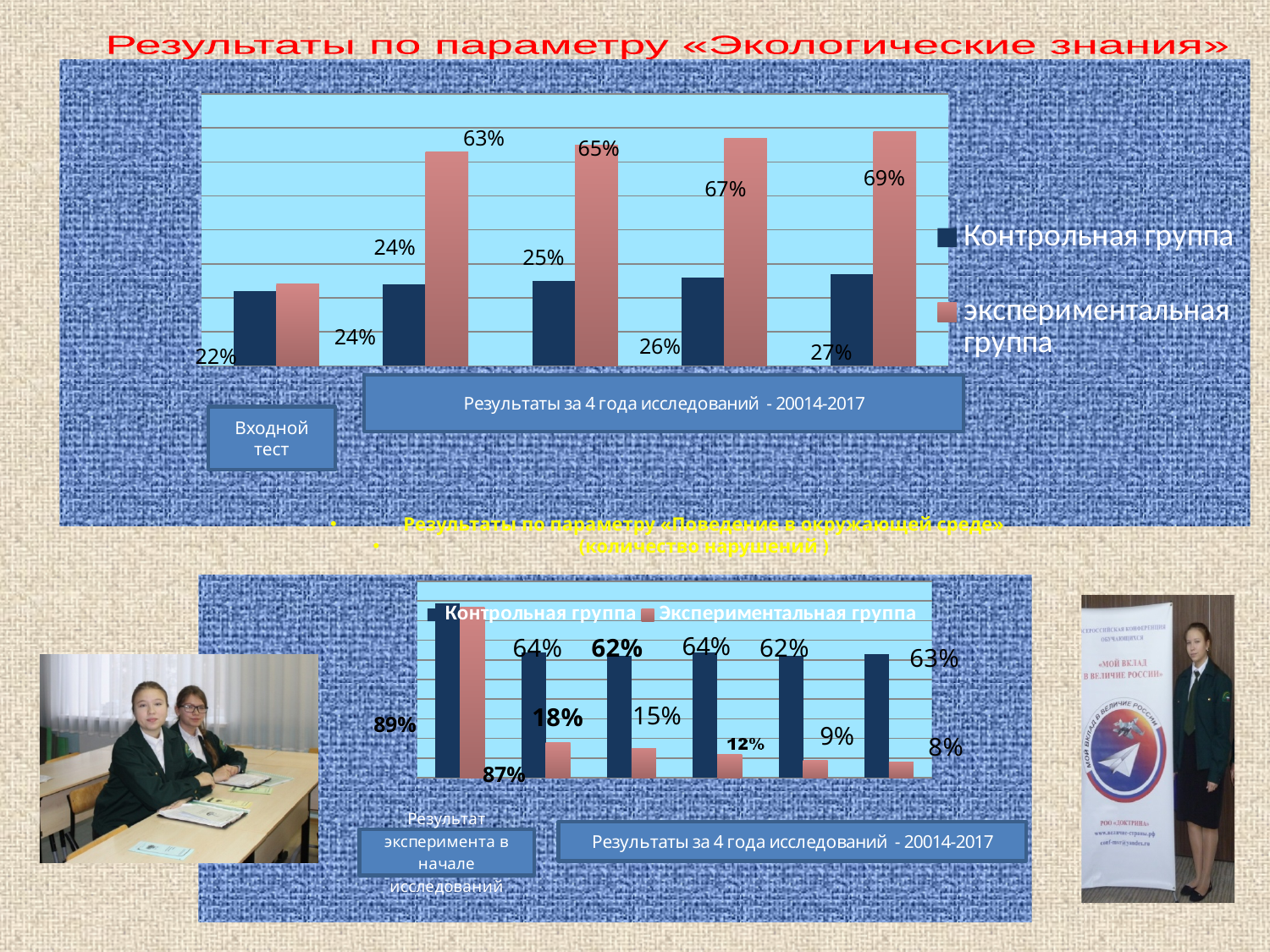
How many groups of bars are shown in the top chart? 5 In the top chart, what is the difference between the rightmost экспериментальная группа bar (69%) and the rightmost Контрольная группа bar (27%)? 42 percentage points In the top chart, what is the value of the leftmost bar for the Контрольная группа series? 22% What kind of chart is the top chart on the slide? Bar chart How many series does the legend of the top chart list? 2 In the bottom chart, what is the lowest value shown for the Экспериментальная группа series? 8% In the bottom chart, what is the value of the leftmost bar for the Экспериментальная группа series? 87% In the bottom chart, which is larger in the leftmost group: the Контрольная группа bar or the Экспериментальная группа bar? Контрольная группа In the top chart, what is the value of the rightmost bar for the экспериментальная группа series? 69% How many groups of bars are shown in the bottom chart? 6 In the top chart, do the values for the Контрольная группа series rise or fall from left to right? Rise In the bottom chart, do the values for the Экспериментальная группа series rise or fall from left to right? Fall